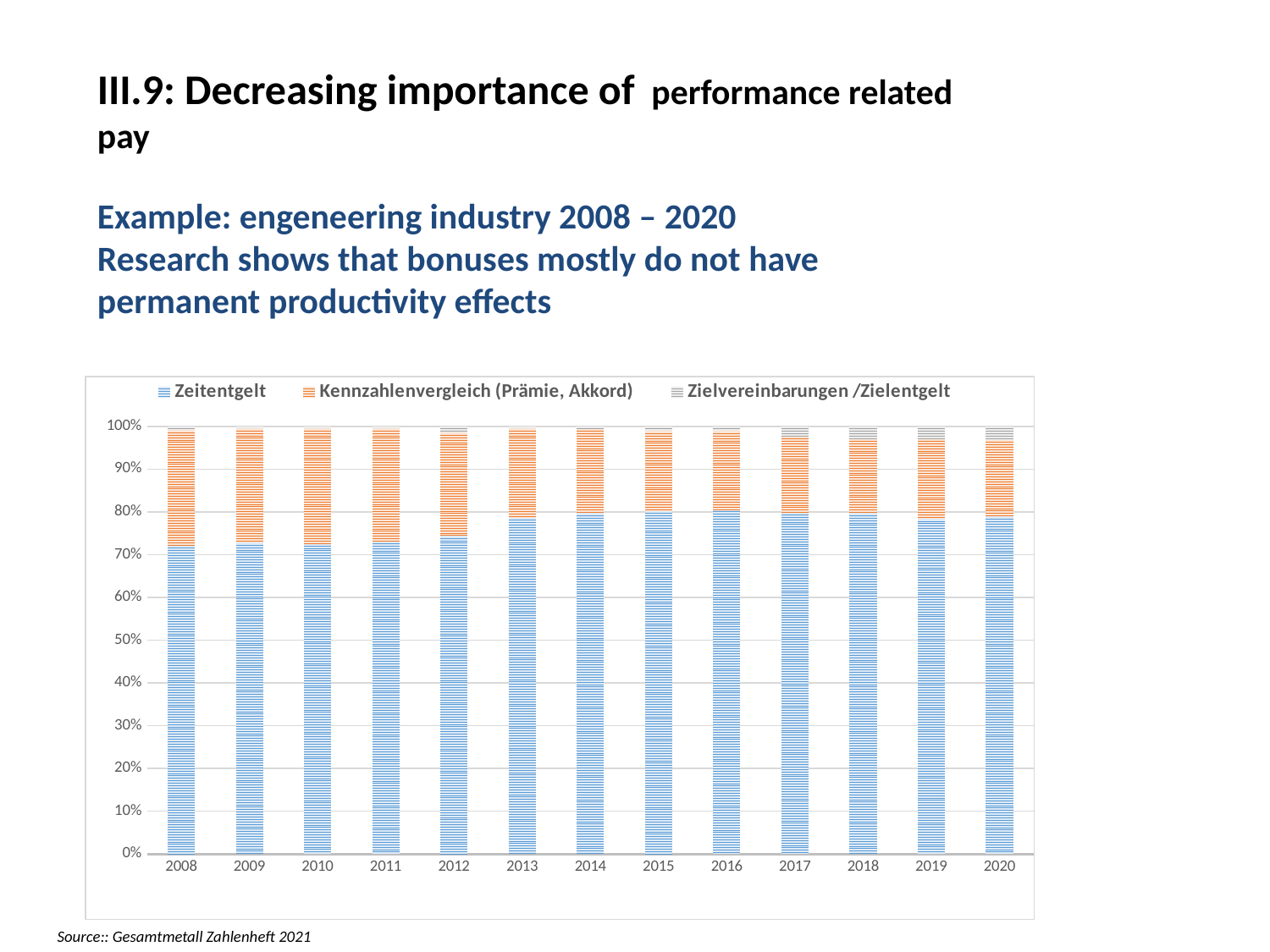
How many series does the chart legend list? 3 Is the Zeitentgelt share for 2015 greater or less than 70%? greater What is the first year shown on the x axis of the chart? 2008 Is the Zeitentgelt share for 2010 greater or less than 80%? less Does the Kennzahlenvergleich (Prämie, Akkord) share generally rise or fall from 2008 to 2020? fall Which year has the larger Zeitentgelt share, 2008 or 2015? 2015 Is the Zeitentgelt share for 2008 greater or less than 70%? greater How many years are shown on the x axis of the chart? 13 What kind of chart is shown on the slide? Stacked bar chart Does the Zeitentgelt share generally rise or fall from 2008 to 2020? rise Which series is shown in orange in the chart? Kennzahlenvergleich (Prämie, Akkord)